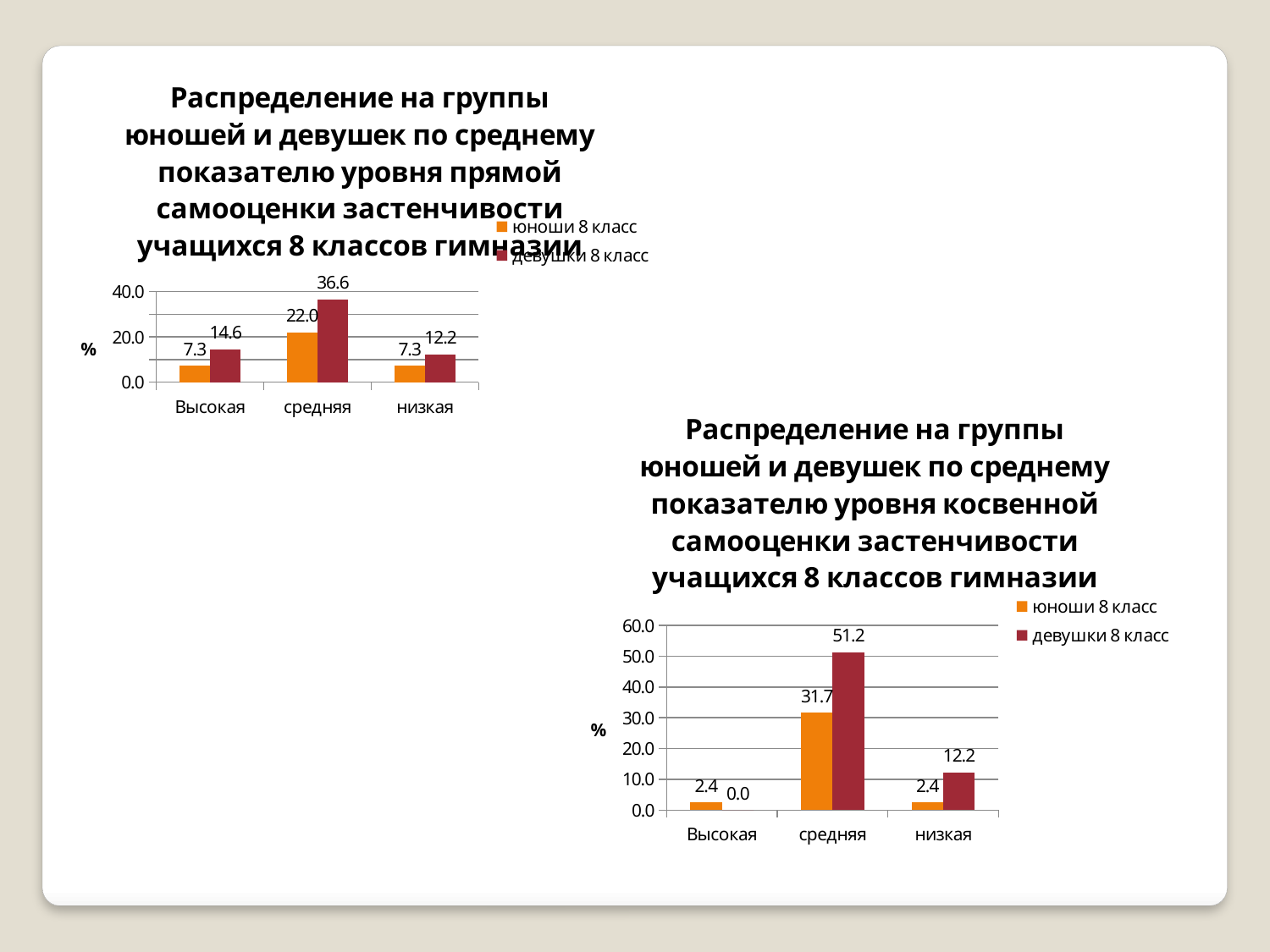
In the top-left chart (direct self-assessment of shyness), which category has the lowest value for девушки 8 класс? низкая In the bottom-right chart (indirect self-assessment of shyness), what is the difference between девушки 8 класс and юноши 8 класс in the низкая category? 9.8 What kind of chart is the bottom-right chart (indirect self-assessment of shyness)? bar chart In the bottom-right chart (indirect self-assessment of shyness), which is larger in the средняя category: юноши 8 класс or девушки 8 класс? девушки 8 класс How many series does the legend of the bottom-right chart (indirect self-assessment of shyness) list? 2 In the top-left chart (direct self-assessment of shyness), what is the difference between девушки 8 класс and юноши 8 класс in the средняя category? 14.6 In the bottom-right chart (indirect self-assessment of shyness), what is the value for девушки 8 класс in the Высокая category? 0.0 In the top-left chart (direct self-assessment of shyness), what is the value for девушки 8 класс in the средняя category? 36.6 In the bottom-right chart (indirect self-assessment of shyness), which category has the highest value for юноши 8 класс? средняя How many categories are shown on the x axis of the top-left chart (direct self-assessment of shyness)? 3 In the bottom-right chart (indirect self-assessment of shyness), what is the value for девушки 8 класс in the средняя category? 51.2 In the top-left chart (direct self-assessment of shyness), what is the value for юноши 8 класс in the Высокая category? 7.3